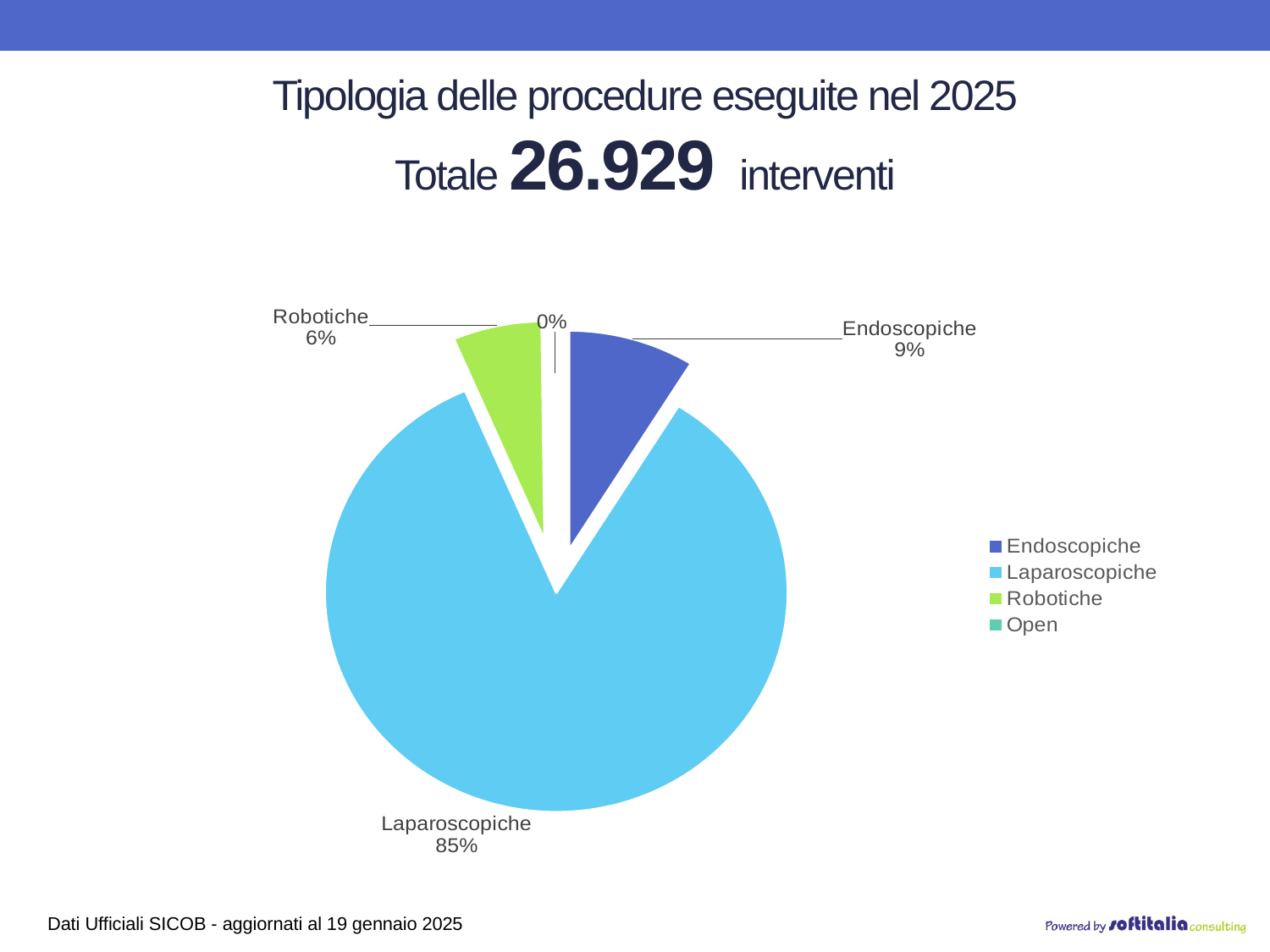
What share of the pie does Laparoscopiche represent? 85% What share of the pie does Endoscopiche represent? 9% Which category has the smallest slice of the pie? Open What percentage is shown for the Open slice? 0% What total number of interventions is stated in the slide title? 26.929 How many categories does the legend list? 4 What colour is the Laparoscopiche slice? light blue What is the difference in percentage points between the Laparoscopiche and Endoscopiche slices? 76 What share of the pie does Robotiche represent? 6% Which category has the largest slice of the pie? Laparoscopiche What kind of chart is shown on the slide? pie chart Which is larger, the Endoscopiche slice or the Robotiche slice? Endoscopiche